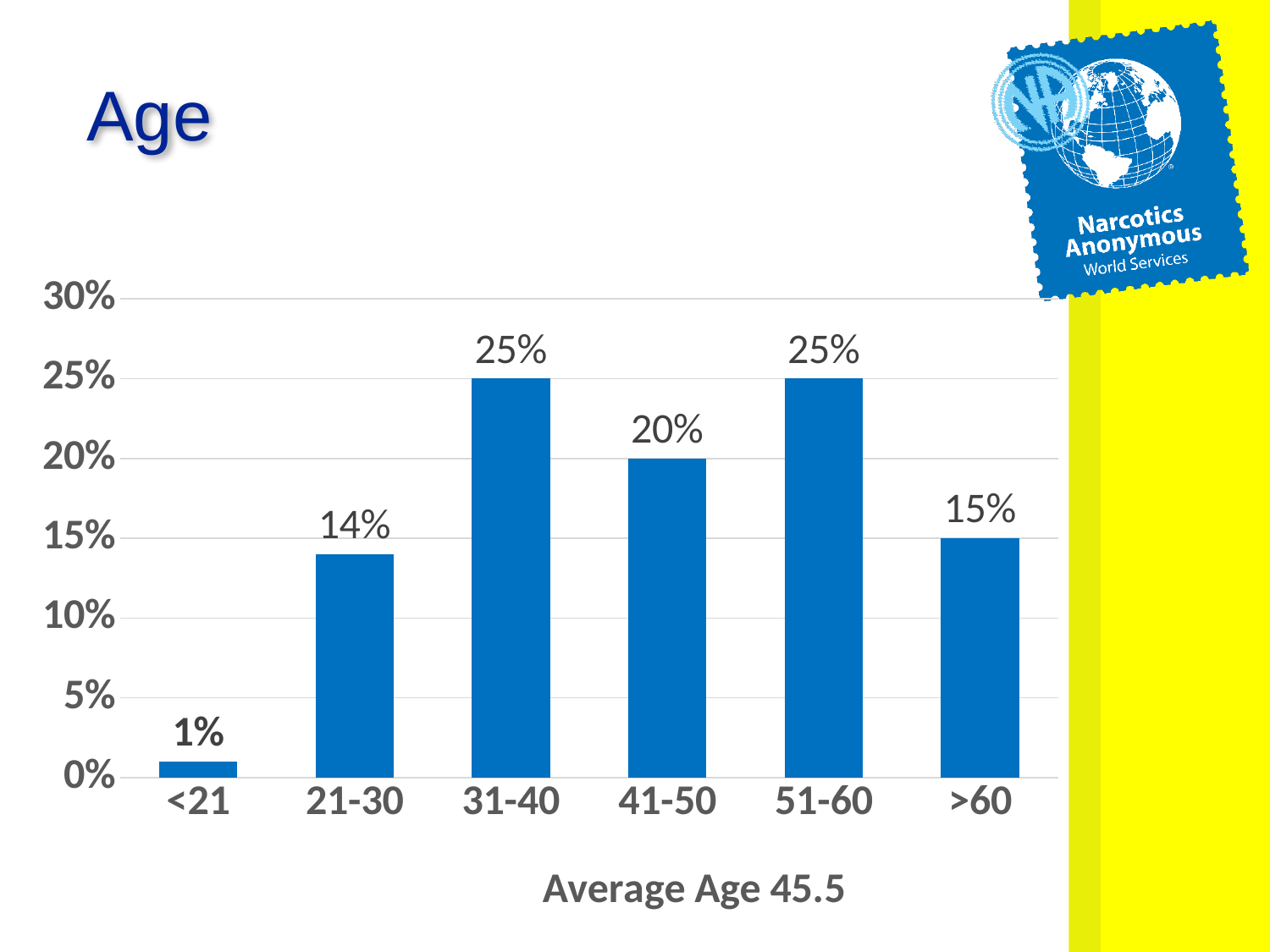
What kind of chart is shown on the slide? Bar chart Is the value for 41-50 greater or less than 15%? greater What is the difference between the values for >60 and <21? 14% What is the value for the >60 age group? 15% Which two age groups share the highest value? 31-40 and 51-60 What average age is stated below the chart? 45.5 What is the value for the 21-30 age group? 14% What is the difference between the values for 31-40 and 41-50? 5% How many age groups are shown on the chart? 6 What is the value for the 41-50 age group? 20% Which age group has the lowest value? <21 Which is larger, the value for 21-30 or the value for >60? >60